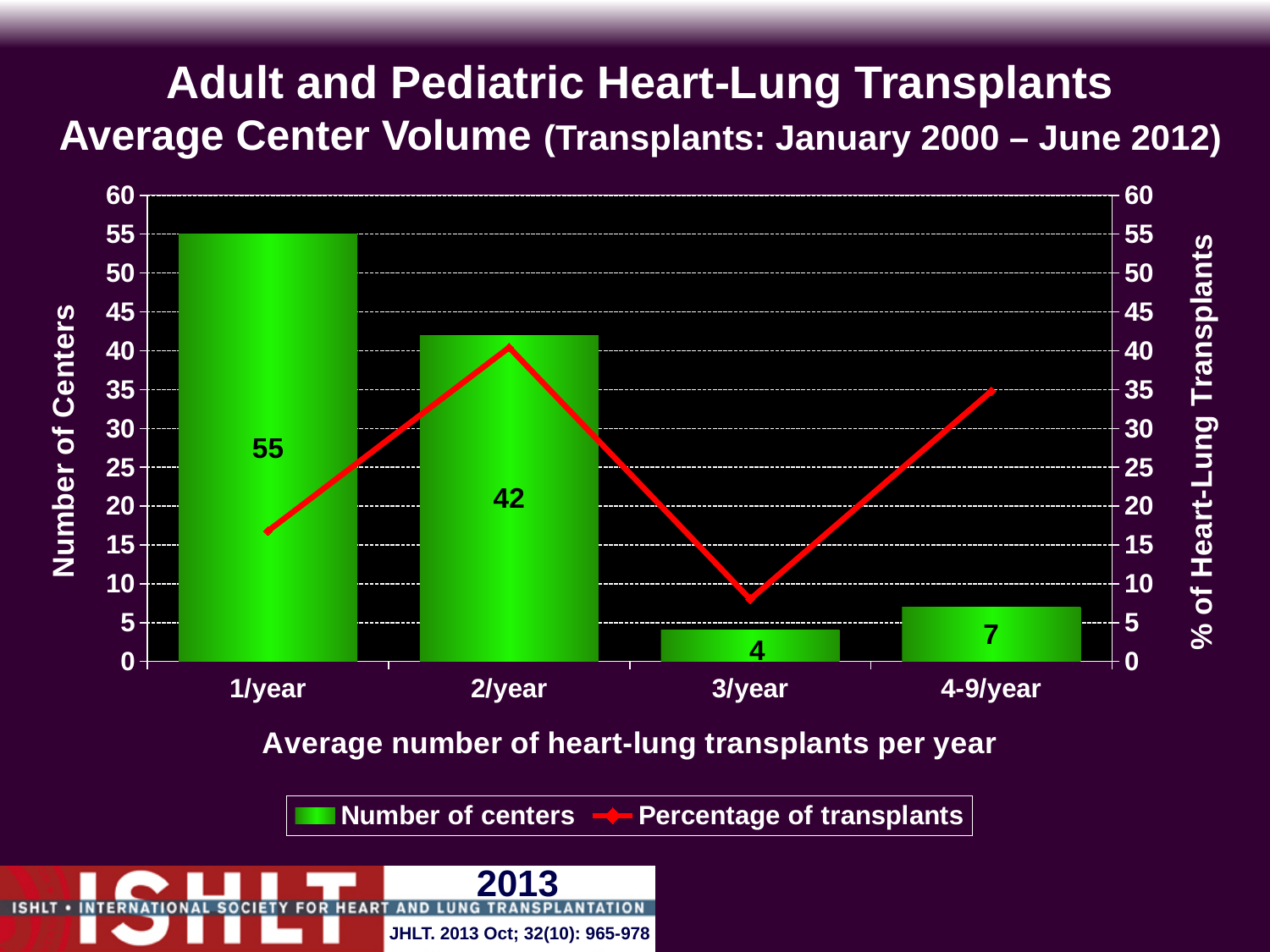
What is the number of centers in the 4-9/year category? 7 Which category has the lowest number of centers? 3/year Is the percentage of transplants for the 3/year category greater or less than 10? less What is the label of the right-hand y axis? % of Heart-Lung Transplants What is the number of centers in the 2/year category? 42 What is the difference in number of centers between the 1/year and 2/year categories? 13 How many centers perform 1 heart-lung transplant per year on average? 55 Which category has the highest number of centers? 1/year How many series does the legend list? 2 Which has more centers, the 3/year category or the 4-9/year category? 4-9/year How many categories are shown on the x axis? 4 Is the percentage of transplants for the 2/year category greater or less than 35? greater